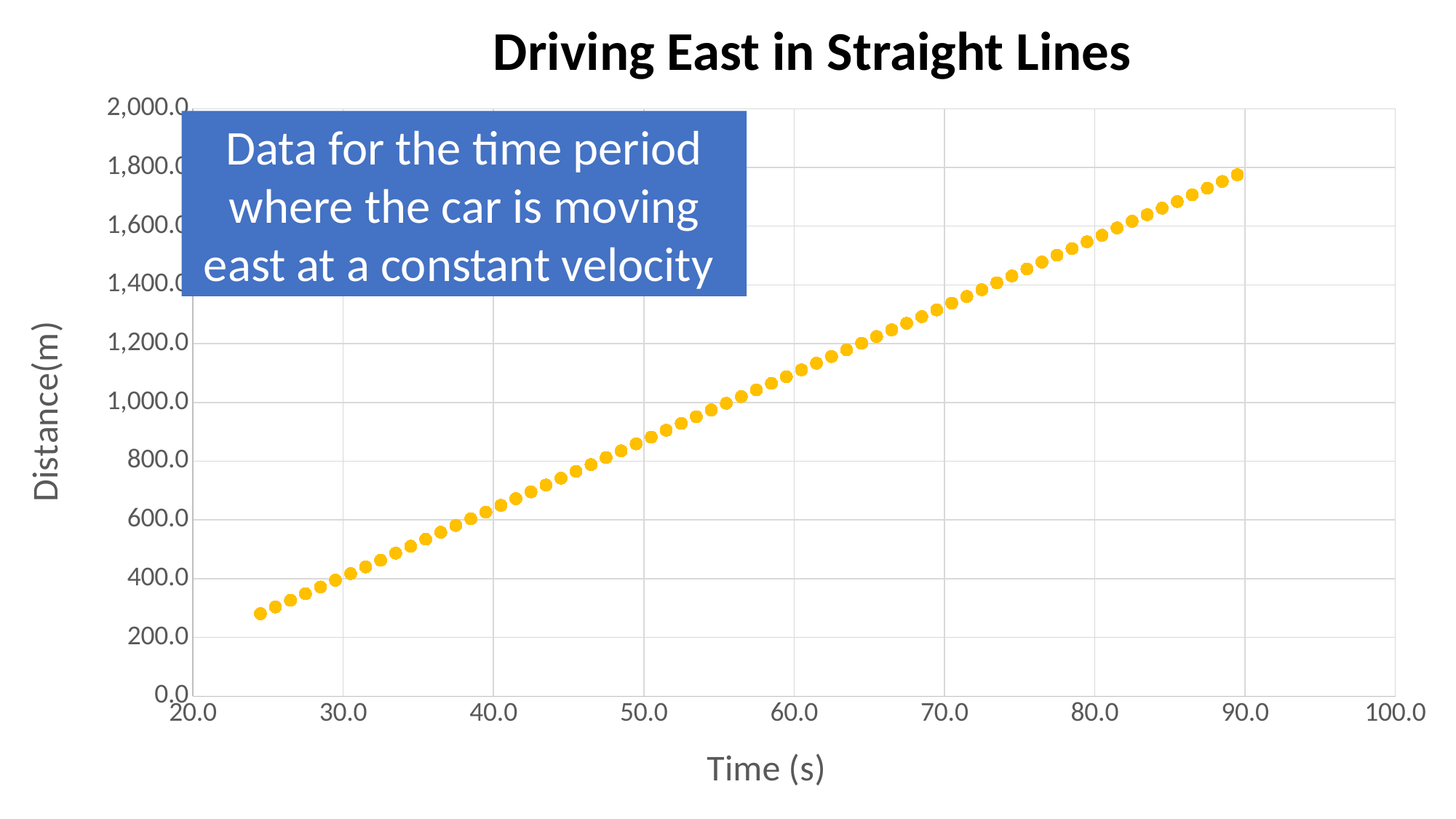
Is the lowest plotted distance value greater or less than 200.0 m? greater Is the distance value at a time of 30.0 s greater or less than 600.0 m? less What is the title of the chart? Driving East in Straight Lines Do the plotted distance values rise or fall as time increases along the x axis? rise What is the label of the vertical axis? Distance(m) Is the distance value at a time of 50.0 s greater or less than 800.0 m? greater What kind of chart is shown on the slide? scatter chart